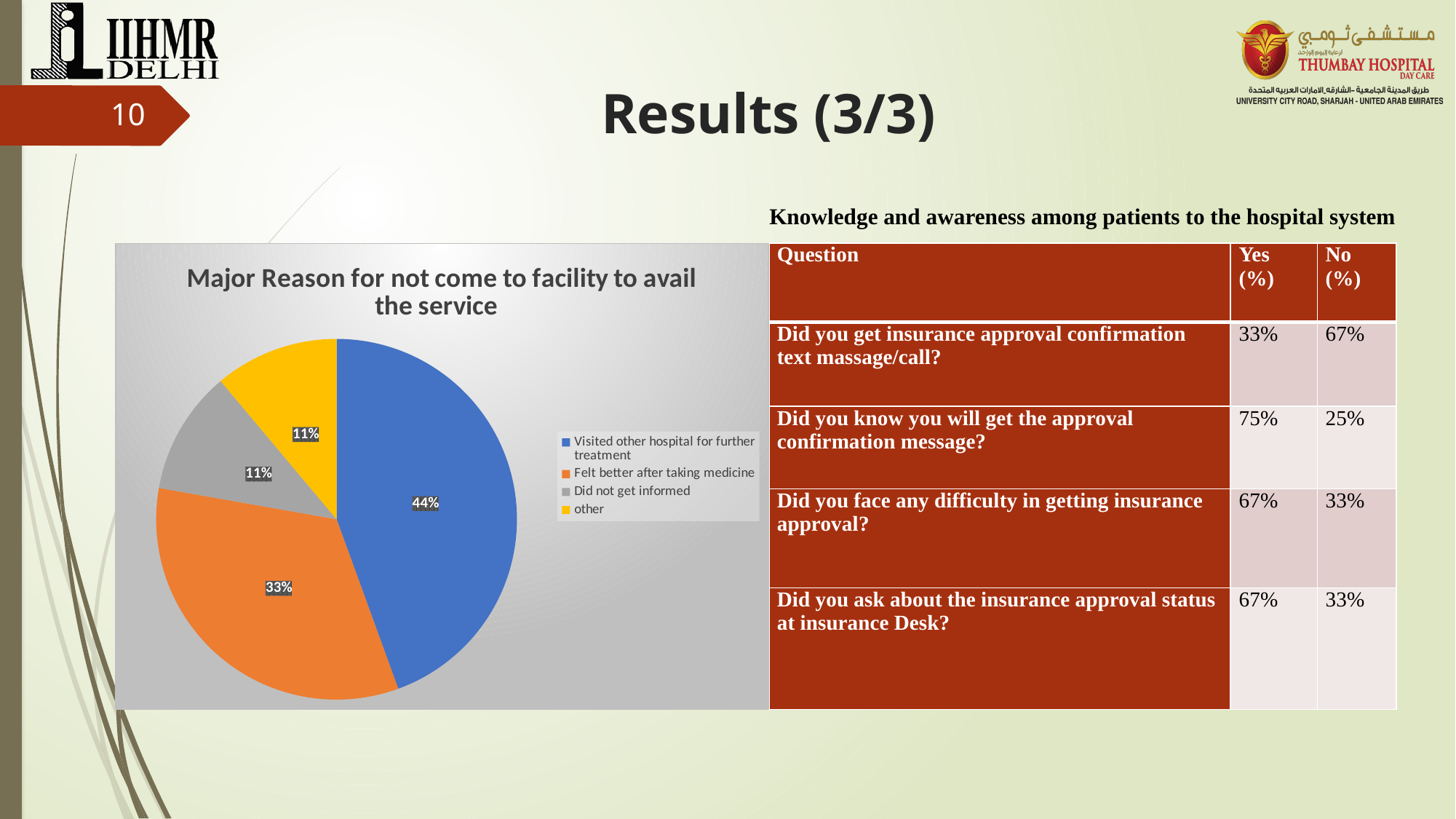
Which category has the largest share of the pie? Visited other hospital for further treatment What type of chart is shown on the slide? Pie chart What percentage is shown for 'Did not get informed'? 11% What share of the pie is 'Visited other hospital for further treatment'? 44% What percentage is shown for the 'other' category? 11% What is the title of the pie chart? Major Reason for not come to facility to avail the service Which is larger: the share for 'Felt better after taking medicine' or the share for 'Did not get informed'? Felt better after taking medicine What percentage is shown for 'Felt better after taking medicine'? 33% What colour is the slice for 'Felt better after taking medicine'? Orange What is the difference in percentage points between 'Visited other hospital for further treatment' and 'Felt better after taking medicine'? 11 Which two categories share the smallest slice of the pie? Did not get informed and other How many categories does the pie chart show? 4